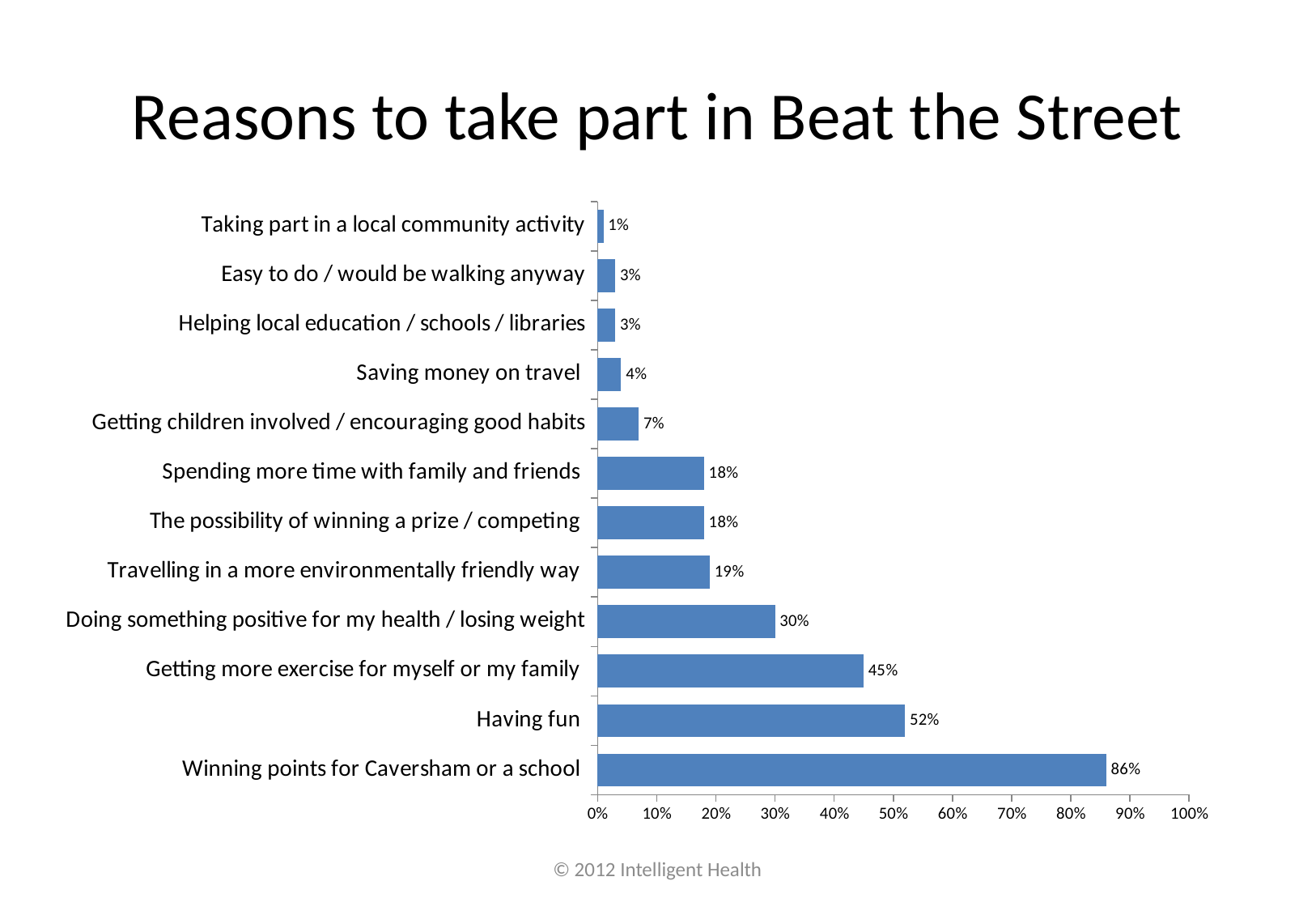
Is the value for 'Getting more exercise for myself or my family' greater or less than 40%? greater What percentage is shown for 'Winning points for Caversham or a school'? 86% What percentage is shown for 'Having fun'? 52% Which reason has the lowest percentage? Taking part in a local community activity What kind of chart is shown on the slide? Bar chart What is the title of the chart? Reasons to take part in Beat the Street Which is larger: 'Doing something positive for my health / losing weight' or 'Travelling in a more environmentally friendly way'? Doing something positive for my health / losing weight How many reasons are listed in the chart? 12 What is the difference in percentage points between 'Having fun' and 'Getting more exercise for myself or my family'? 7% What percentage is shown for 'Saving money on travel'? 4% What is the maximum value shown on the horizontal axis? 100% Which reason has the highest percentage? Winning points for Caversham or a school